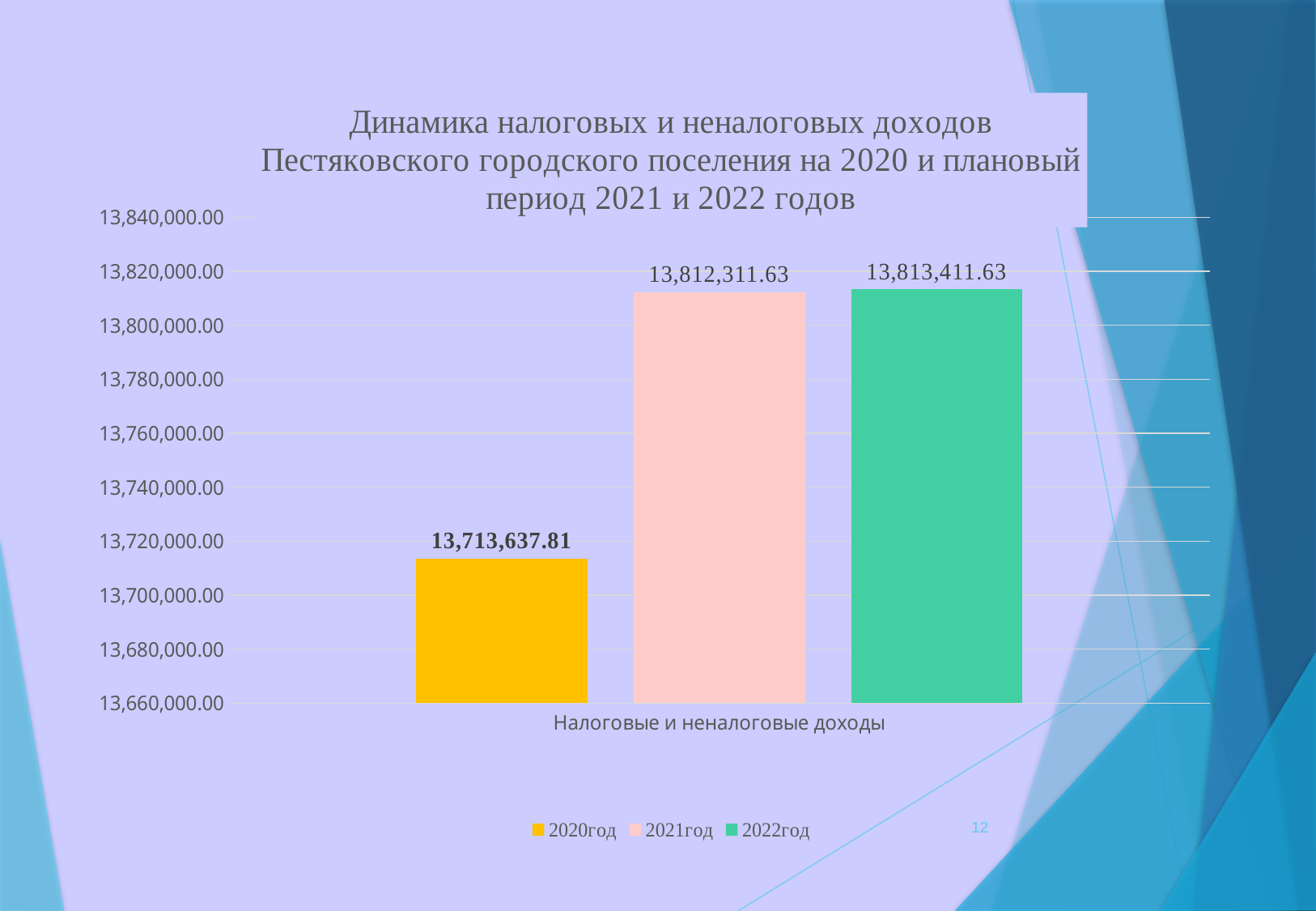
What is the difference between the values for 2022год and 2021год? 1,100.00 Which is larger, the value for 2020год or the value for 2021год? 2021год What is the value for 2022год in the chart? 13,813,411.63 Which year has the lowest value in the chart? 2020год What kind of chart is shown on the slide? bar chart What is the value for 2021год in the chart? 13,812,311.63 What is the value for 2020год in the chart? 13,713,637.81 What is the difference between the values for 2021год and 2020год? 98,673.82 How many series does the legend list? 3 Which year has the highest value in the chart? 2022год Is the value for 2020год greater or less than 13,720,000.00? less Do the values rise or fall from 2020год to 2022год? rise